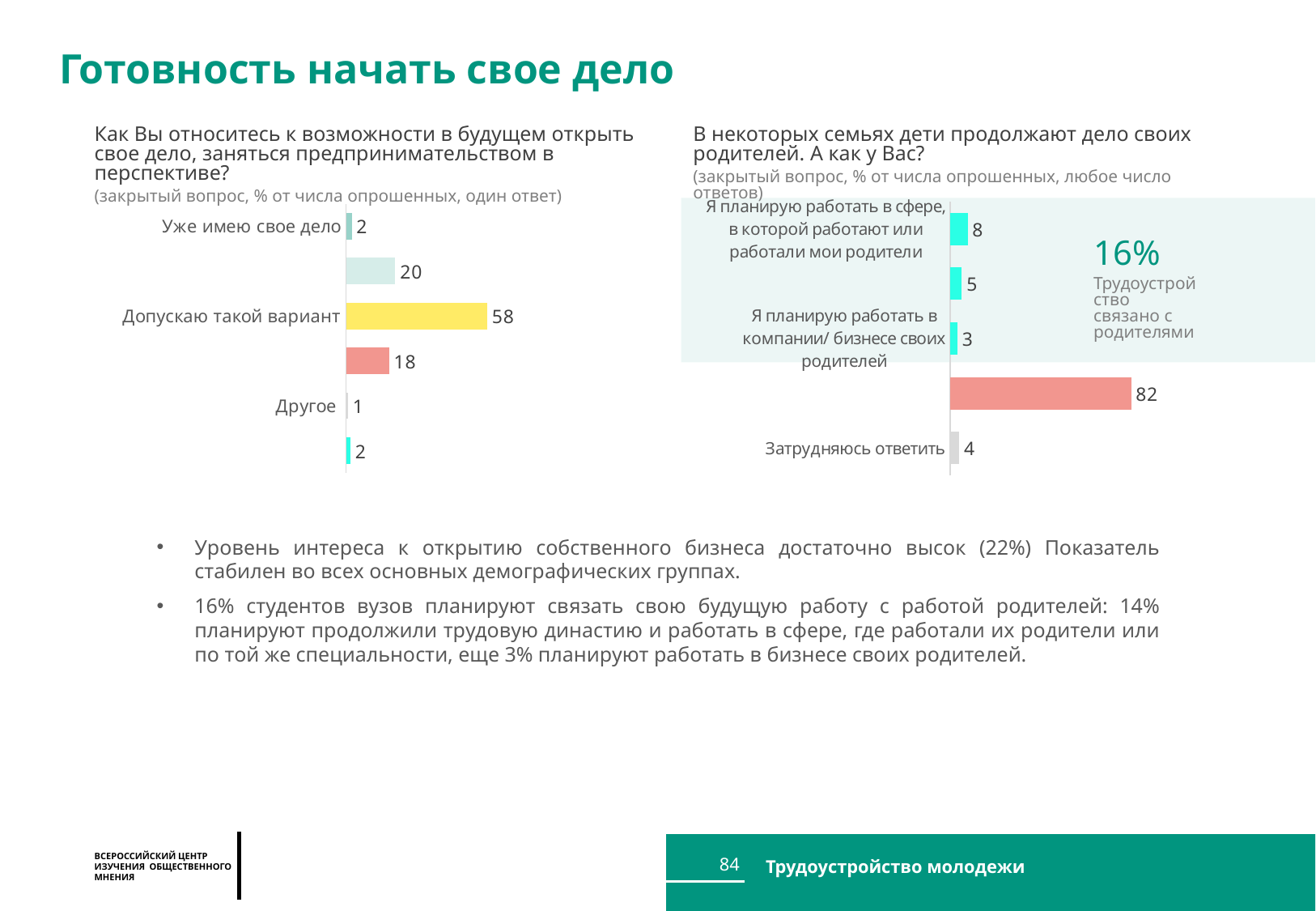
What type of chart is used on the left side of the slide? Bar chart On the left chart, what is the value for "Допускаю такой вариант"? 58 On the right chart, what is the highest value shown? 82 On the right chart, what is the value for "Я планирую работать в компании/ бизнесе своих родителей"? 3 On the left chart, how many bars are plotted? 6 On the right chart, what is the value for "Затрудняюсь ответить"? 4 On the right chart, what is the value for "Я планирую работать в сфере, в которой работают или работали мои родители"? 8 On the left chart, what is the value for "Уже имею свое дело"? 2 On the left chart, what is the value for "Другое"? 1 On the left chart, what is the difference between the values for "Допускаю такой вариант" and "Уже имею свое дело"? 56 On the right chart, how many bars are plotted? 5 On the left chart, which category has the highest value? Допускаю такой вариант